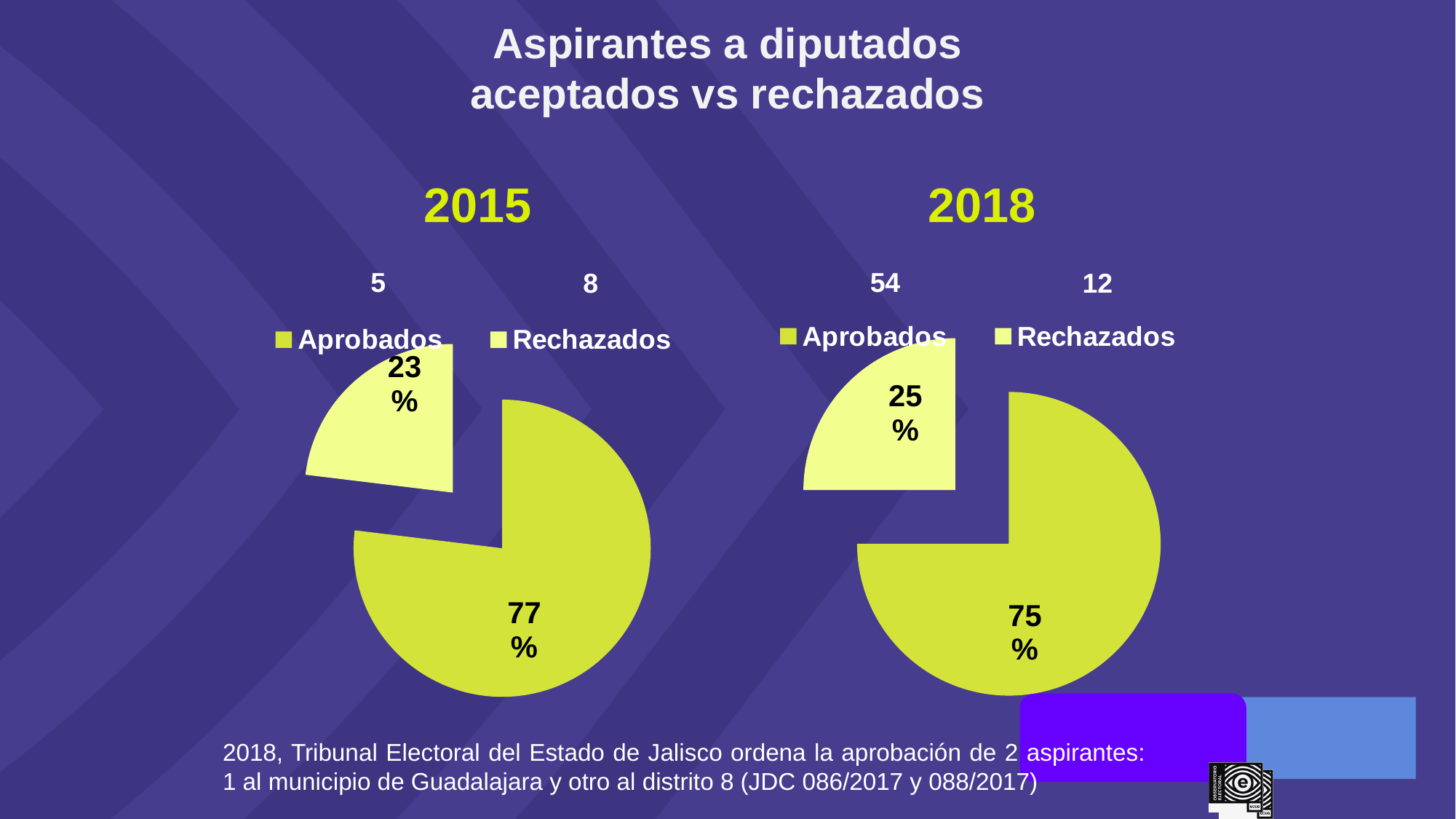
In the 2015 pie chart, what share is labelled for Rechazados? 23% In the 2015 pie chart, what is the difference in percentage points between the Aprobados and Rechazados shares? 54 percentage points What kind of chart is used for the 2015 data? Pie chart What is the title of the slide containing the two pie charts? Aspirantes a diputados aceptados vs rechazados What are the two legend entries shown for the pie charts? Aprobados and Rechazados In the 2015 pie chart, what share is labelled for Aprobados? 77% In the 2015 pie chart, which category has the largest slice? Aprobados Is the Aprobados share larger in the 2015 pie chart or the 2018 pie chart? 2015 In the 2018 pie chart, what share is labelled for Rechazados? 25% In the 2018 pie chart, which category has the smallest slice? Rechazados How many categories does each pie chart show? 2